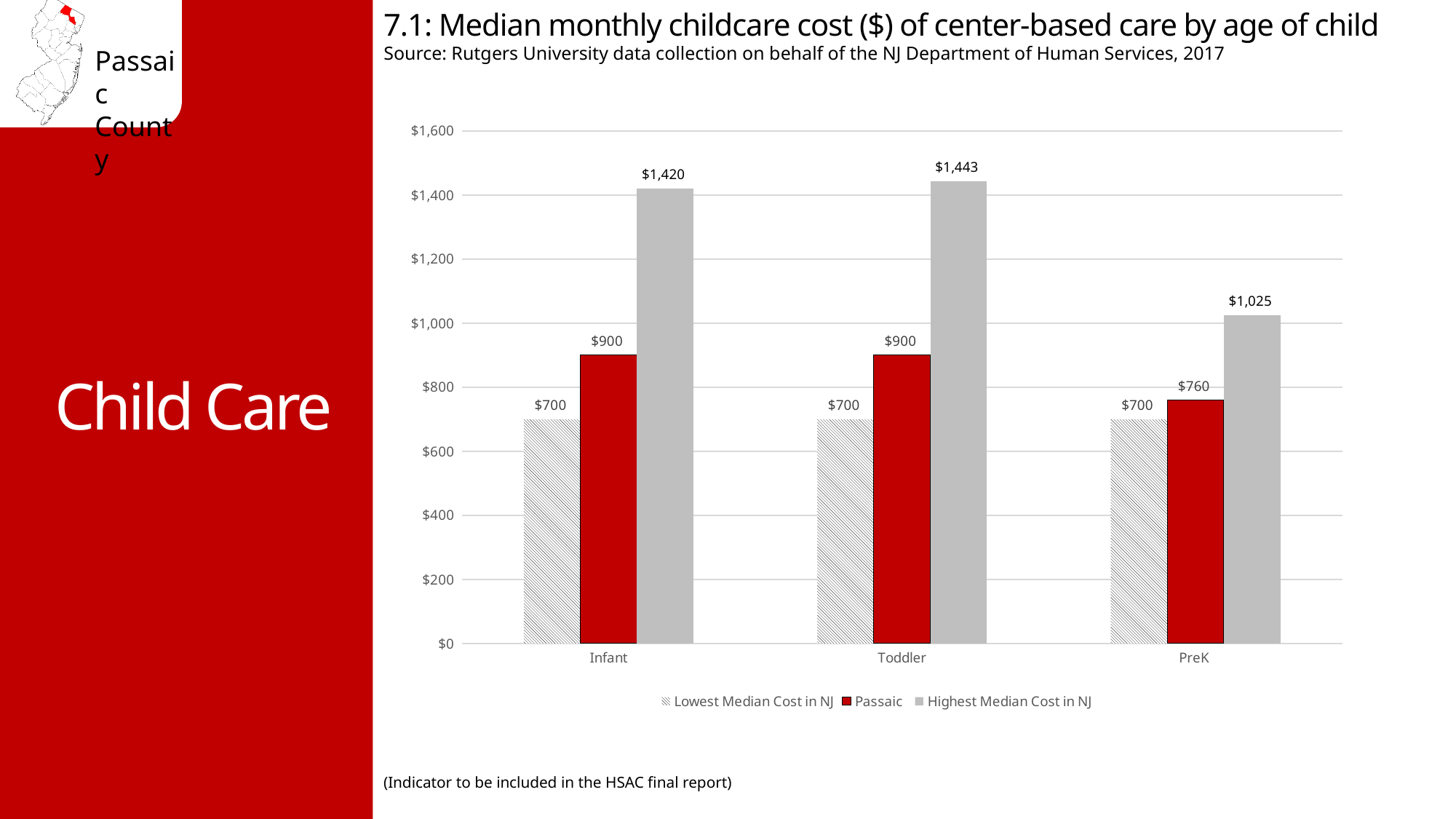
How many age groups are shown on the x axis? 3 What is the Passaic median monthly cost for PreK care? $760 What is the Passaic median monthly childcare cost for Infant care? $900 What is the difference between the Highest Median Cost in NJ and the Passaic cost for Infant care? $520 For which age group is the Passaic median cost the lowest? PreK For which age group is the Highest Median Cost in NJ the largest? Toddler How many series does the legend list? 3 What colour are the Passaic bars? Red What is the Lowest Median Cost in NJ for PreK care? $700 What kind of chart is shown on the slide? Bar chart What is the Highest Median Cost in NJ for Toddler care? $1,443 Which is larger: the Highest Median Cost in NJ for PreK or the Highest Median Cost in NJ for Infant? Highest Median Cost in NJ for Infant